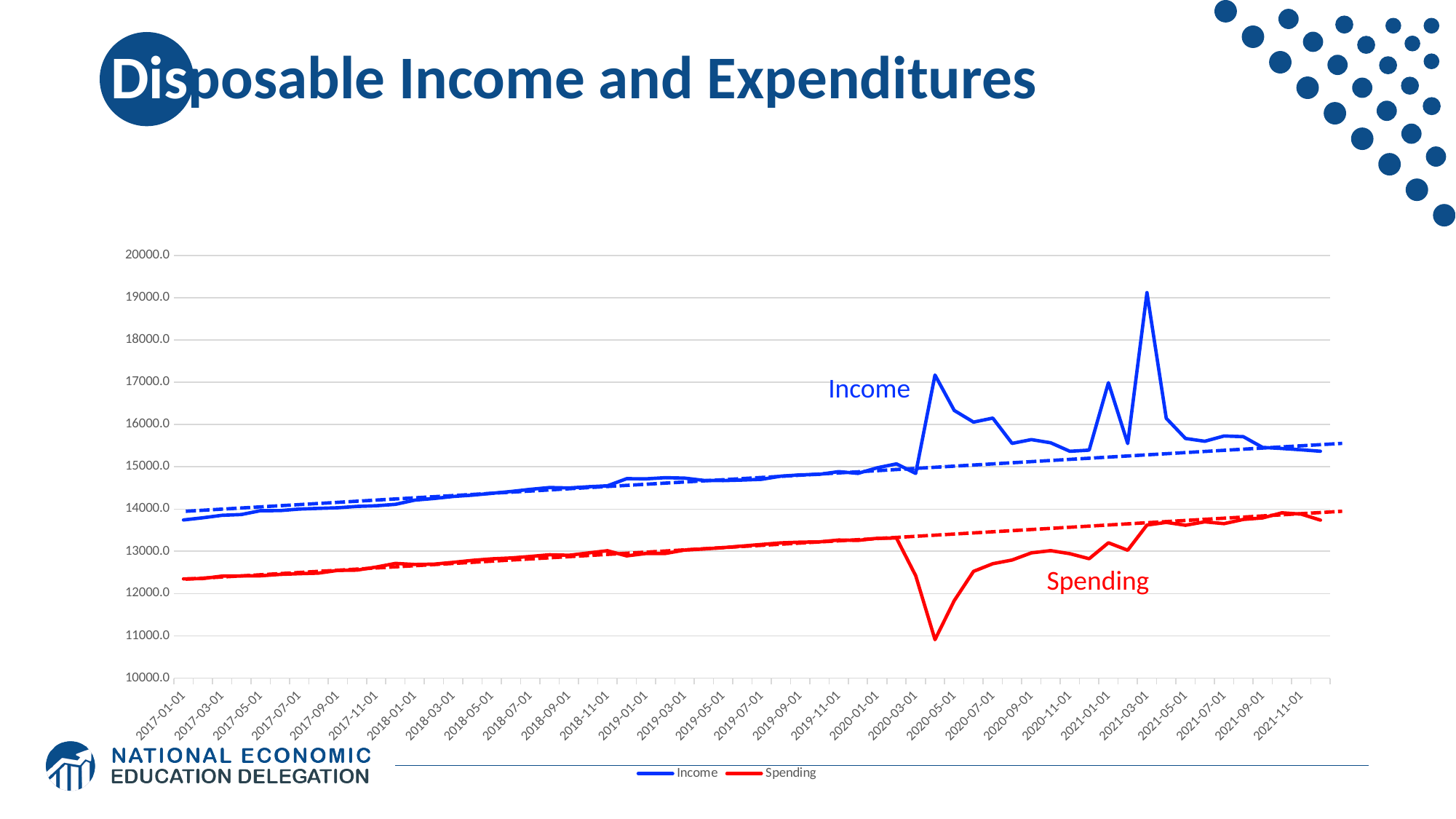
Which series reaches the highest value on the chart? Income Is the highest Income value on the chart greater or less than 18000.0? greater Is the lowest Spending value on the chart greater or less than 12000.0? less How many series does the legend list? 2 Is the Income value at 2017-01-01 greater or less than 14000.0? less Which series is higher at 2019-01-01, Income or Spending? Income Does the Income line generally rise or fall from 2017-01-01 to 2021-11-01? rise Which colour is used for the Spending line? red What is the title of the slide's chart? Disposable Income and Expenditures Which series reaches the lowest value on the chart? Spending What kind of chart is shown on the slide? line chart